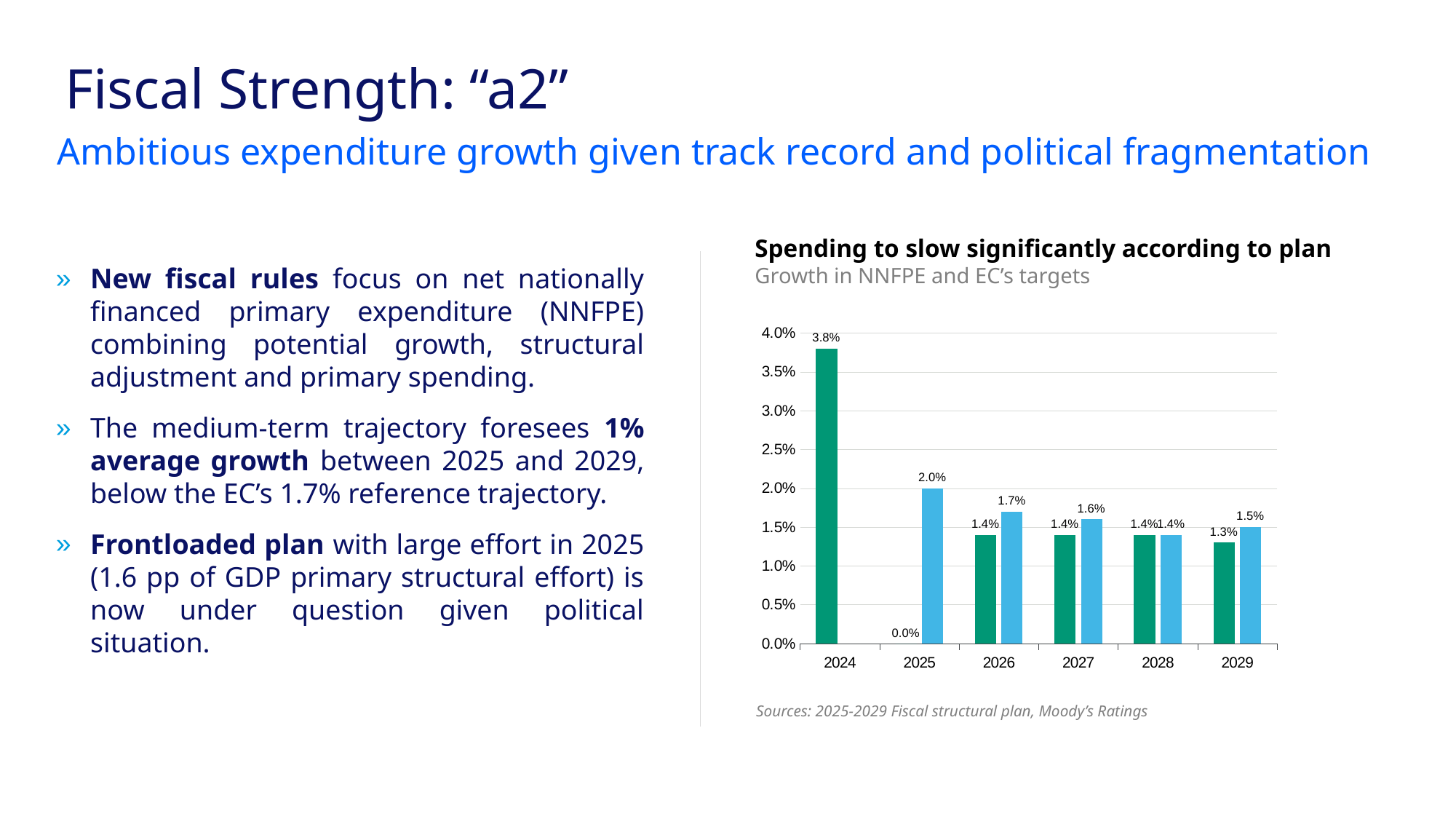
Do the blue bars rise or fall from 2025 to 2027? fall What is the title of the chart? Spending to slow significantly according to plan What kind of chart is shown on the slide? bar chart What is the value of the green bar for 2029? 1.3% What is the value of the green bar for 2024? 3.8% What is the value of the blue bar for 2027? 1.6% Which year has the lowest green bar? 2025 Which is larger in 2029, the green bar or the blue bar? the blue bar How many years are shown on the x axis? 6 What is the value of the blue bar for 2025? 2.0% What is the difference between the blue bar and the green bar in 2026? 0.3% Which year has the highest green bar? 2024